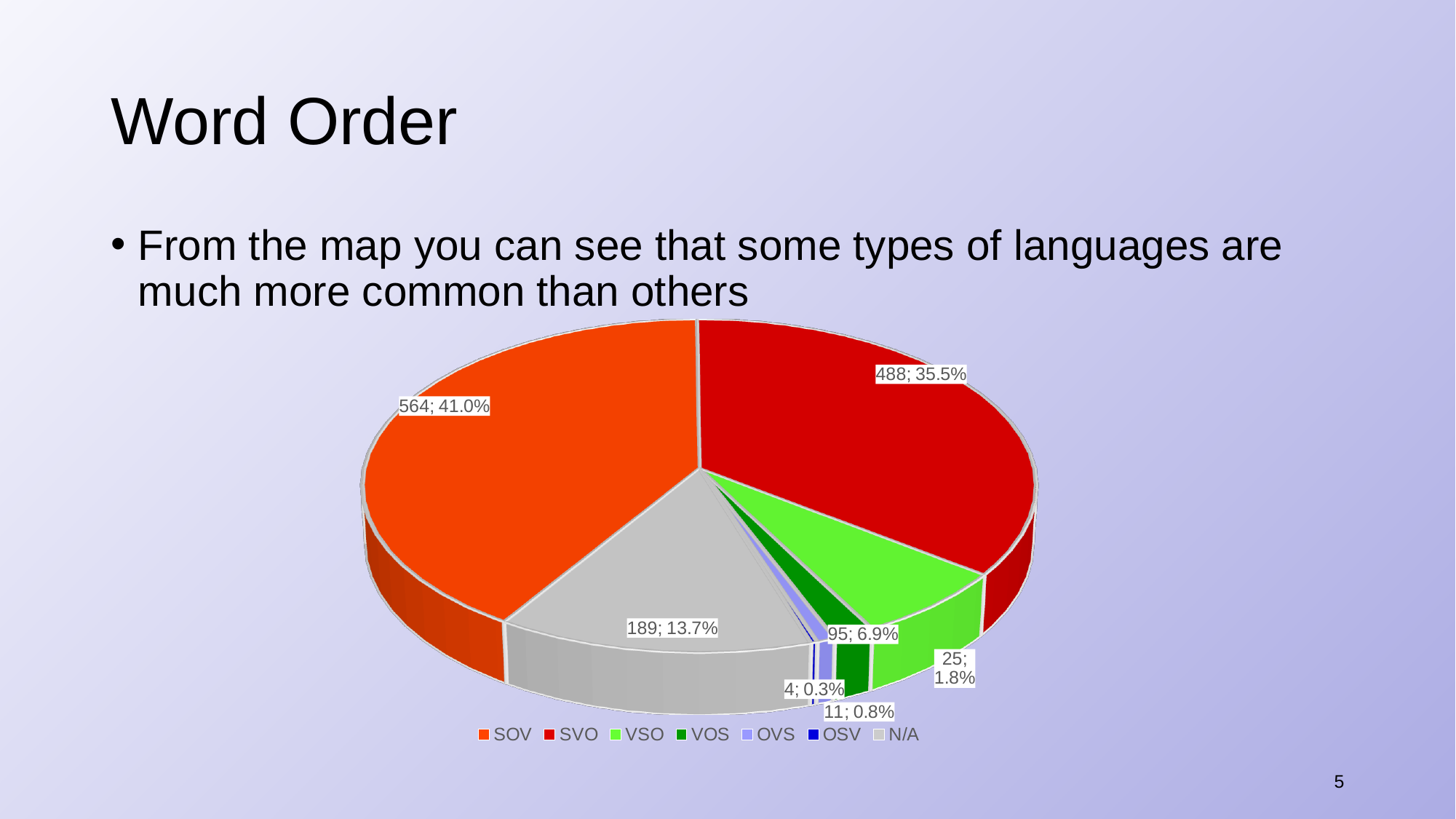
How many slices does the pie chart have? 7 Which word order category has the smallest slice in the pie chart? OSV What kind of chart is shown on the slide? Pie chart What share of the pie chart is the N/A slice? 13.7% What percentage of the pie chart does the SVO slice represent? 35.5% What is the difference between the SOV value and the SVO value in the pie chart? 76 How many entries does the legend of the pie chart list? 7 What is the value shown for the VSO slice in the pie chart? 95 Which word order category has the largest slice in the pie chart? SOV What is the value shown for the N/A slice in the pie chart? 189 How many languages are in the SOV category in the pie chart? 564 Which is larger in the pie chart, the SVO slice or the N/A slice? SVO